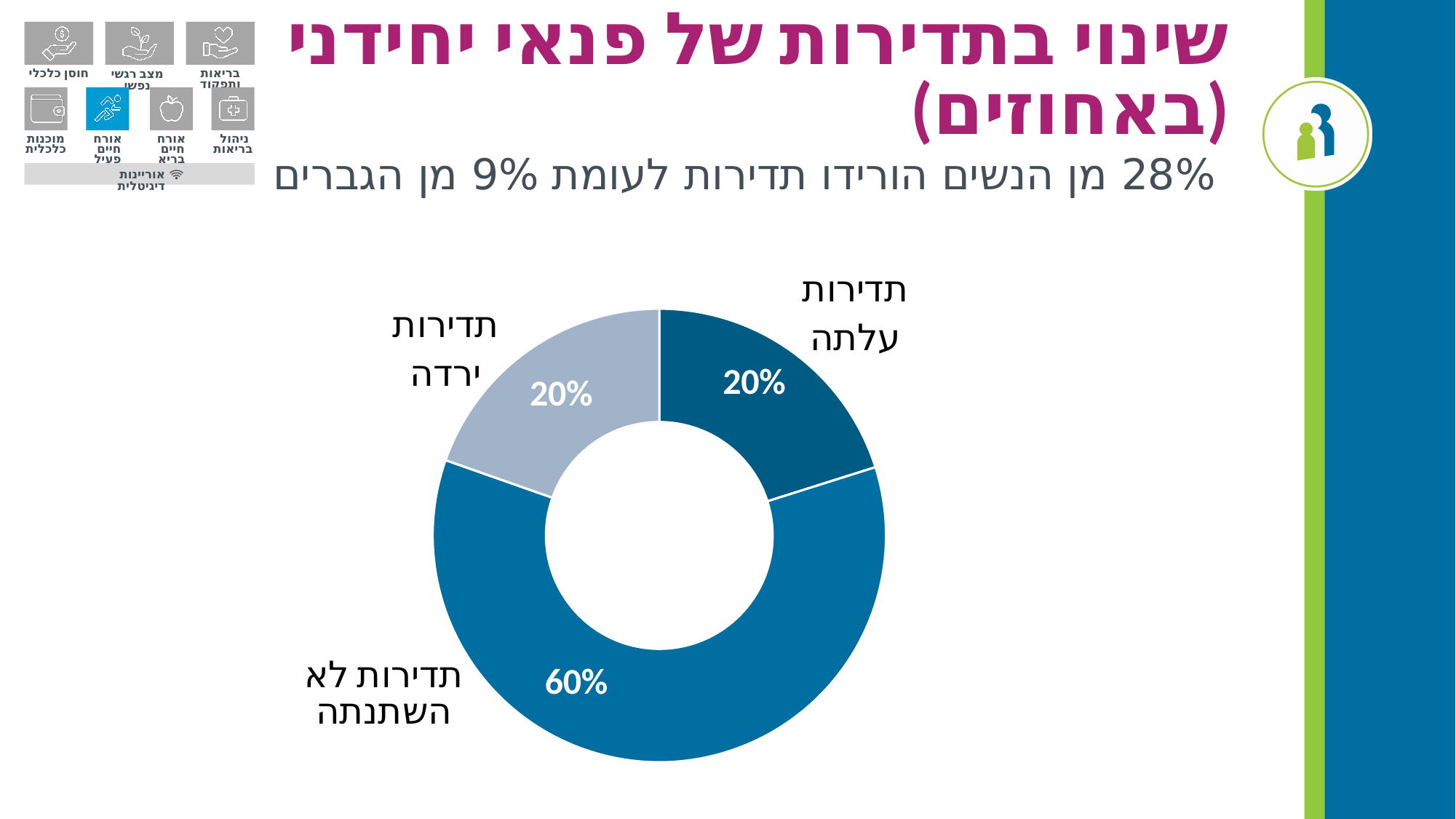
What is the difference in percentage points between תדירות לא השתנתה and תדירות עלתה? 40 percentage points What is the value for תדירות לא השתנתה? 60% What is the title of the chart on the slide? שינוי בתדירות של פנאי יחידני (באחוזים) Which category has the largest share of the chart? תדירות לא השתנתה What is the value for תדירות ירדה? 20% Is the value for תדירות לא השתנתה greater or less than 50%? greater According to the subtitle, what percentage of women reduced their frequency compared with men? 28% of women versus 9% of men What is the value for תדירות עלתה? 20% What type of chart is shown on the slide? Donut (pie) chart Which is larger, the share for תדירות לא השתנתה or the share for תדירות ירדה? תדירות לא השתנתה What is the combined share of תדירות עלתה and תדירות ירדה? 40% How many categories (slices) does the chart have? 3